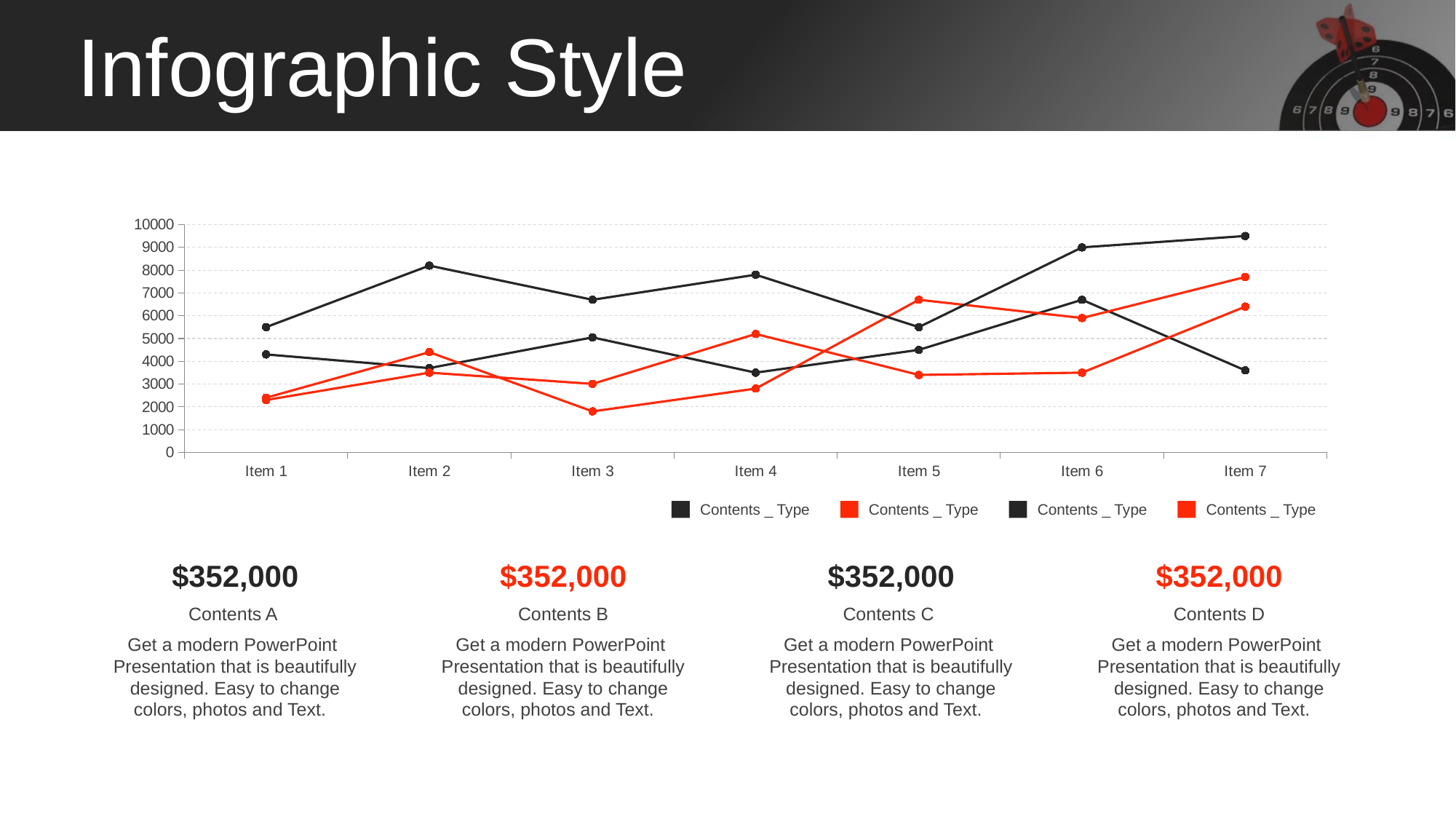
Is the lowest value plotted at Item 1 greater or less than 3000? less What is the maximum value shown on the chart's y axis? 10000 What text is used for each entry in the chart's legend? Contents _ Type How many categories are shown on the x axis of the chart? 7 What is the label of the first category on the x axis? Item 1 Is the lowest value plotted at Item 3 greater or less than 2000? less What kind of chart is shown on the slide? line chart At which category does the highest point on the chart occur? Item 7 At which category does the lowest point on the chart occur? Item 3 Is the highest value plotted at Item 7 greater or less than 9000? greater How many series does the chart's legend list? 4